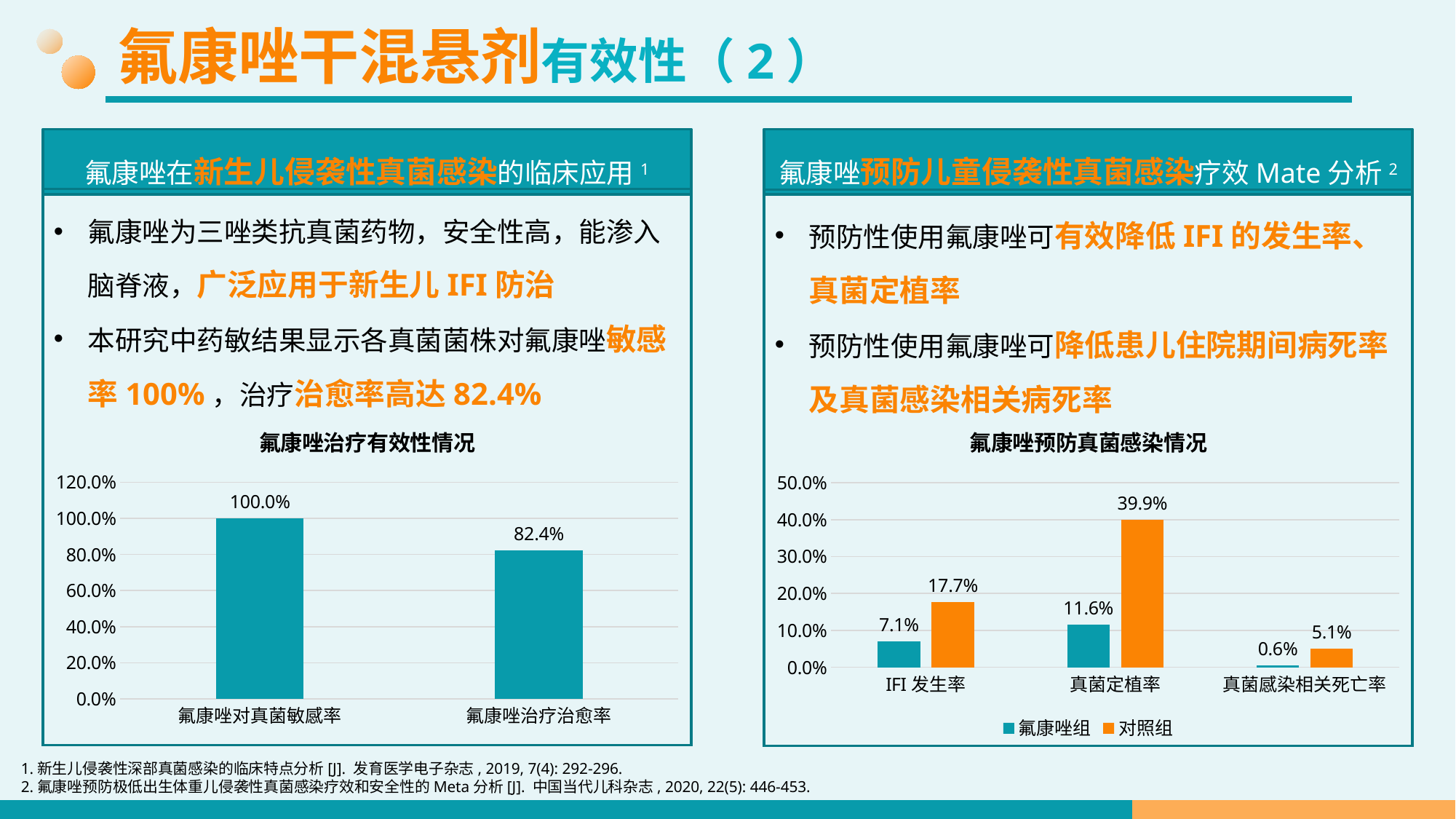
In the chart titled 氟康唑治疗有效性情况, what is the value for 氟康唑对真菌敏感率? 100.0% What kind of chart is the chart titled 氟康唑治疗有效性情况? Bar chart In the chart titled 氟康唑预防真菌感染情况, how many series does the legend list? 2 In the chart titled 氟康唑预防真菌感染情况, what is the value for 氟康唑组 in IFI 发生率? 7.1% In the chart titled 氟康唑预防真菌感染情况, which category has the highest value for 对照组? 真菌定植率 In the chart titled 氟康唑预防真菌感染情况, what is the value for 氟康唑组 in 真菌感染相关死亡率? 0.6% In the chart titled 氟康唑预防真菌感染情况, what is the value for 对照组 in 真菌定植率? 39.9% In the chart titled 氟康唑治疗有效性情况, what is the difference between 氟康唑对真菌敏感率 and 氟康唑治疗治愈率? 17.6% In the chart titled 氟康唑治疗有效性情况, how many categories are shown? 2 In the chart titled 氟康唑预防真菌感染情况, what is the difference between 对照组 and 氟康唑组 for IFI 发生率? 10.6% In the chart titled 氟康唑治疗有效性情况, what is the value for 氟康唑治疗治愈率? 82.4% In the chart titled 氟康唑预防真菌感染情况, which series is shown in orange? 对照组